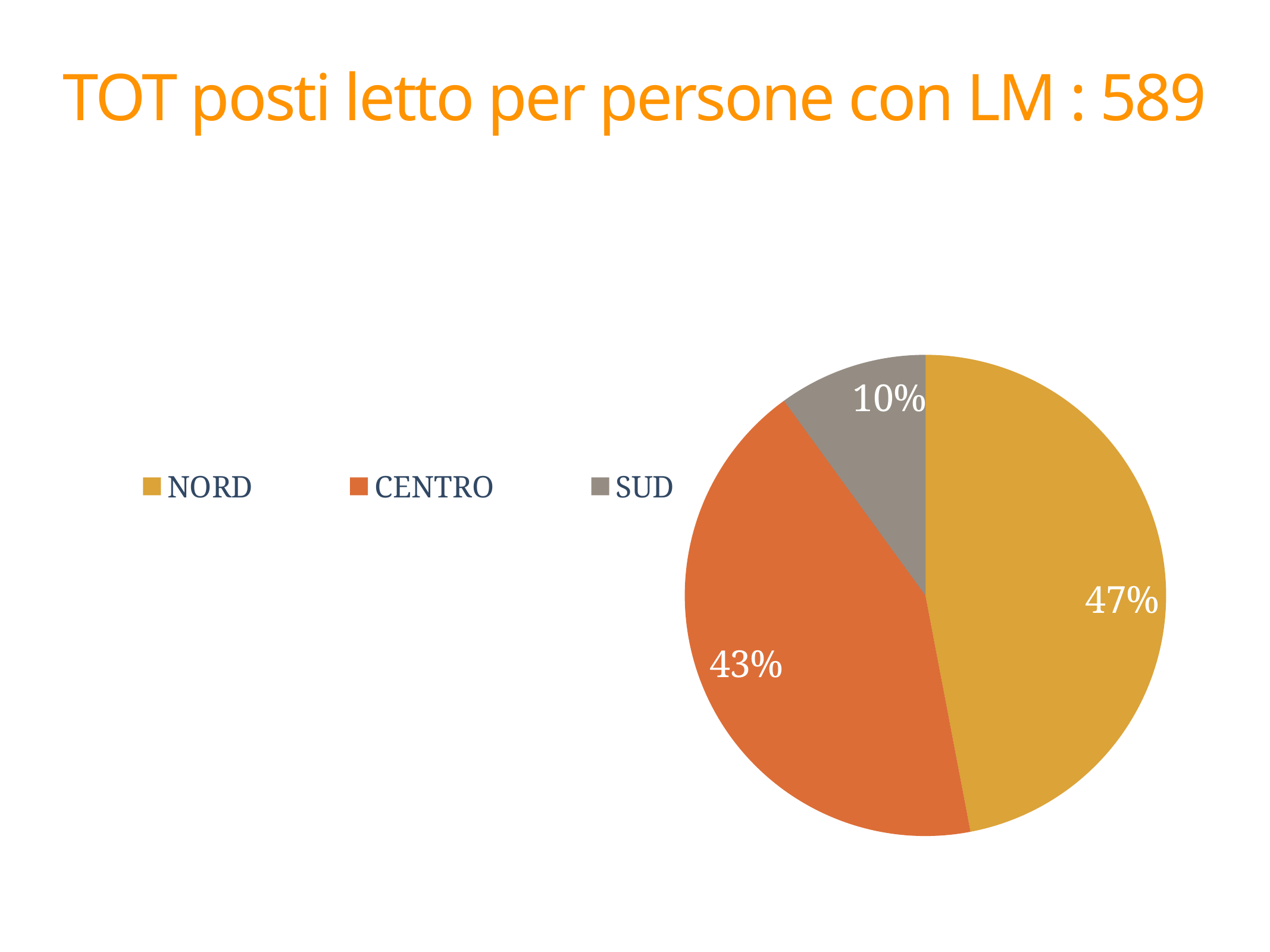
What share of the pie does NORD represent? 47% What is the difference in percentage points between the CENTRO and SUD slices? 33 What share of the pie does SUD represent? 10% Which is larger, the CENTRO slice or the SUD slice? CENTRO What share of the pie does CENTRO represent? 43% Which category has the smallest slice of the pie? SUD What type of chart is shown on the slide? pie chart What is the title of the slide? TOT posti letto per persone con LM : 589 Which category has the largest slice of the pie? NORD What colour is the SUD slice in the pie chart? grey What is the difference in percentage points between the NORD and CENTRO slices? 4 How many categories does the pie chart show? 3